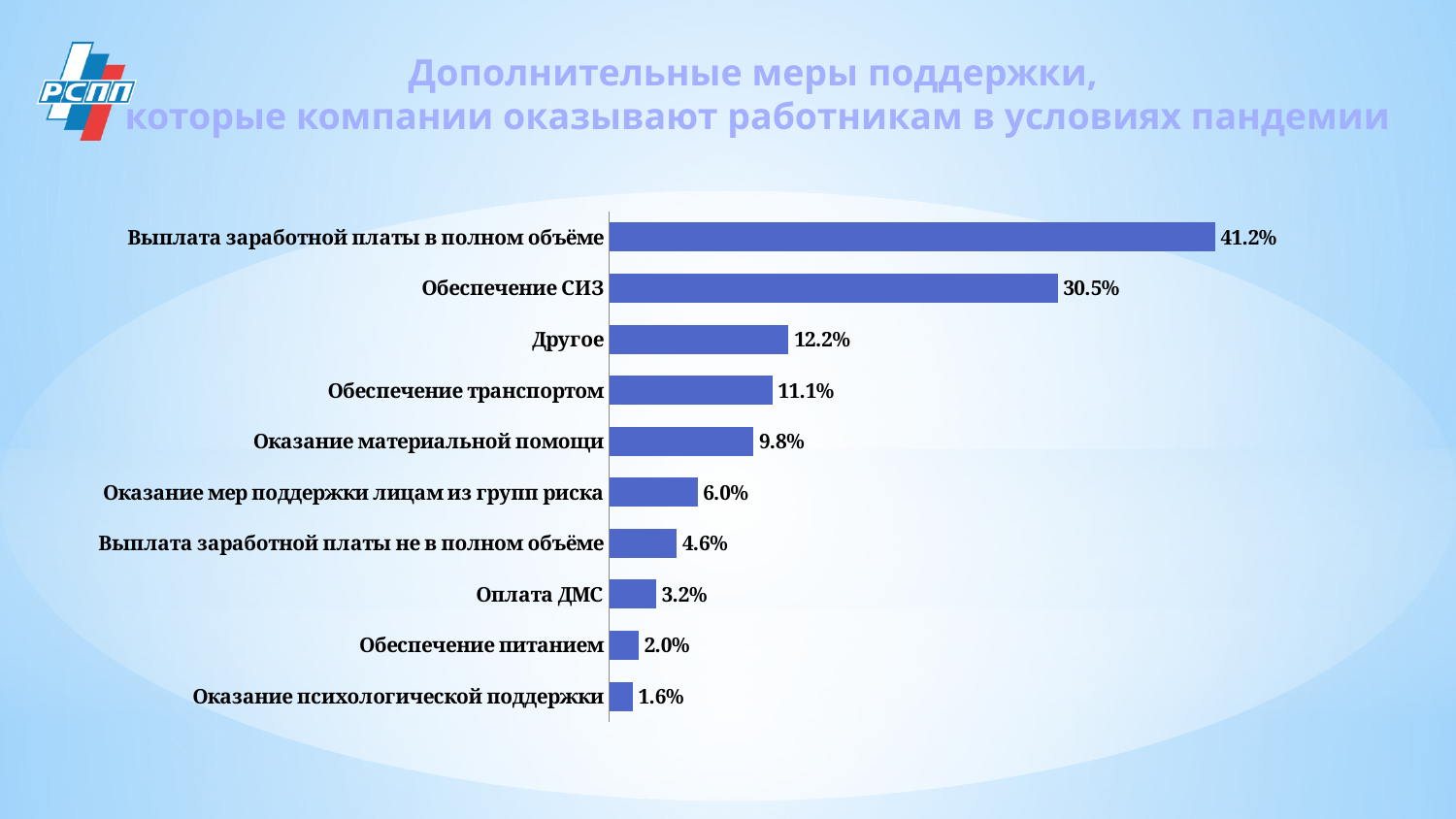
What is the difference between the values for "Другое" and "Обеспечение транспортом"? 1.1% What is the value for "Обеспечение питанием"? 2.0% What is the value for "Выплата заработной платы в полном объёме"? 41.2% What is the value for "Оказание материальной помощи"? 9.8% What kind of chart is shown on the slide? Bar chart Which category has the lowest value? Оказание психологической поддержки What is the difference between the values for "Выплата заработной платы в полном объёме" and "Обеспечение СИЗ"? 10.7% What is the value for "Оплата ДМС"? 3.2% Which is larger: the value for "Оказание мер поддержки лицам из групп риска" or the value for "Выплата заработной платы не в полном объёме"? Оказание мер поддержки лицам из групп риска What is the value for "Обеспечение СИЗ"? 30.5% Which category has the highest value? Выплата заработной платы в полном объёме How many categories are shown in the chart? 10